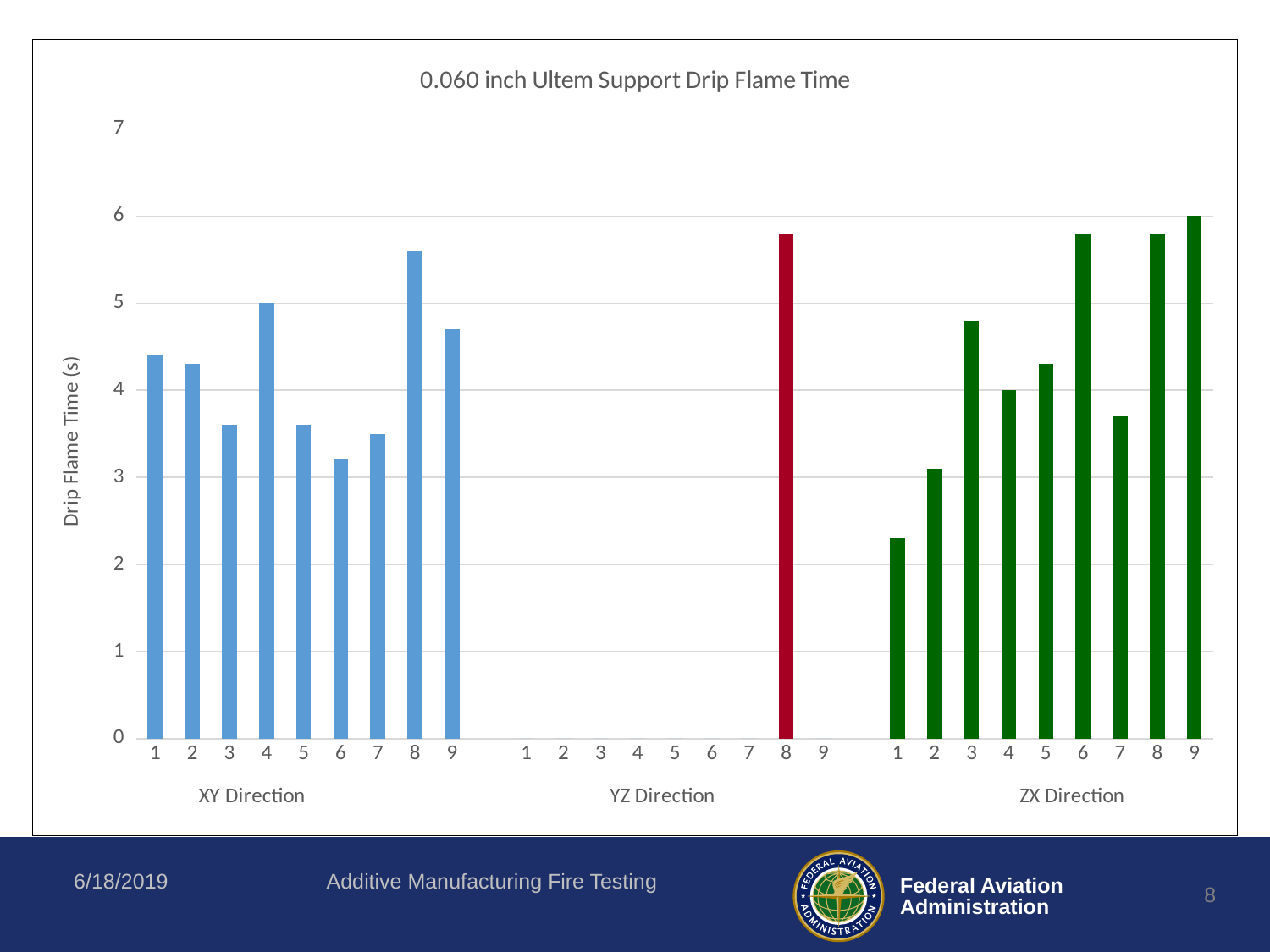
What is the title of the chart? 0.060 inch Ultem Support Drip Flame Time Which sample in the ZX Direction group has the lowest drip flame time? 1 What kind of chart is shown on the slide? bar chart Which sample in the XY Direction group has the highest drip flame time? 8 How many samples in the YZ Direction group show a non-zero bar? 1 Is the drip flame time for sample 1 in the ZX Direction greater or less than 3? less Which has a larger drip flame time: sample 1 in the XY Direction or sample 1 in the ZX Direction? sample 1 in the XY Direction Which sample in the XY Direction group has the lowest drip flame time? 6 Is the drip flame time for sample 8 in the XY Direction greater or less than 5? greater How many samples are plotted in the XY Direction group? 9 What is the label of the vertical axis? Drip Flame Time (s) What is the drip flame time for sample 4 in the XY Direction? 5